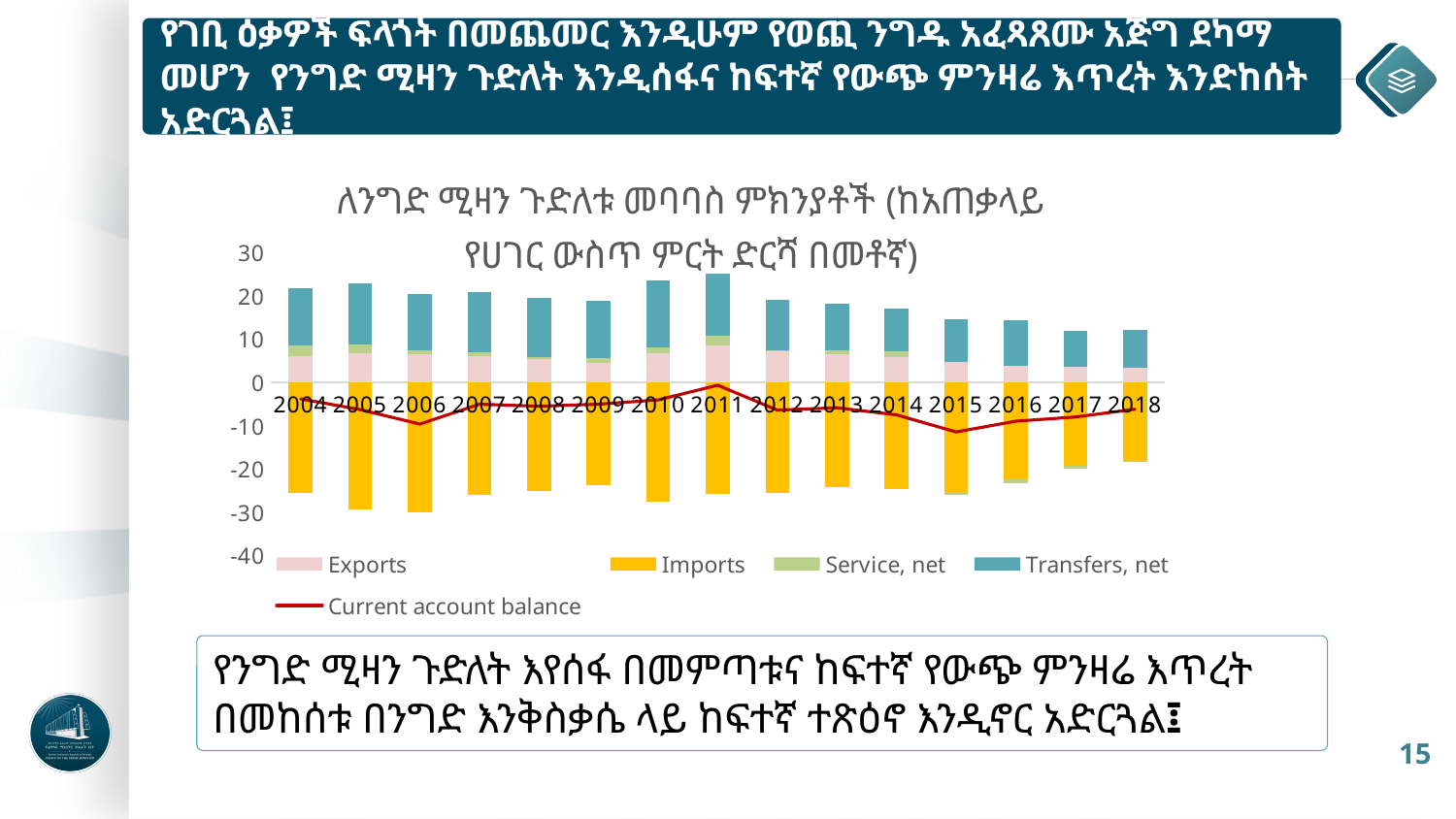
How many series does the chart legend list? 5 Which series is drawn as a red line in the chart? Current account balance Is the top of the positive stacked bar in 2011 greater or less than 20? greater Is the value for Imports in 2011 greater or less than -20? less What is the last year shown on the x axis? 2018 What is the first year shown on the x axis? 2004 Which series is shown in yellow in the chart? Imports What kind of chart is shown on the slide? Stacked bar chart with a line Is the Current account balance in 2004 greater or less than -10? greater How many years are shown on the x axis of the chart? 15 Does the top of the positive stacked bar rise or fall from 2011 to 2018? fall